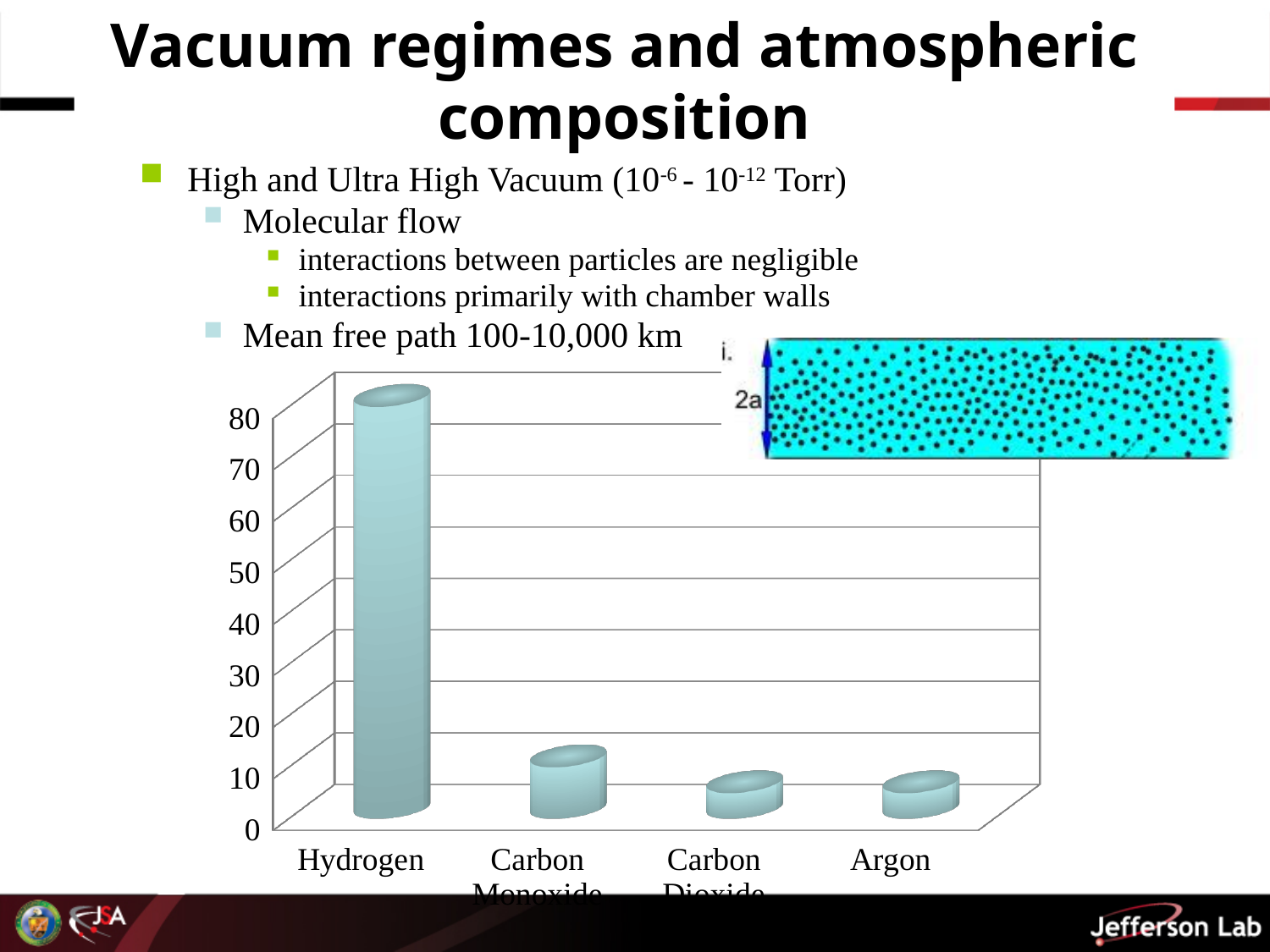
Which is larger, the value for Hydrogen or the value for Carbon Monoxide? Hydrogen Which category is plotted furthest to the left on the chart's horizontal axis? Hydrogen Is the value for Hydrogen greater or less than 70? greater Which is larger, the value for Carbon Monoxide or the value for Argon? Carbon Monoxide How many categories are plotted in the bar chart? 4 Do the bar values generally rise or fall from left to right across the categories? fall Which category has the highest bar in the chart? Hydrogen What kind of chart is shown on the slide? bar chart What is the highest tick value shown on the vertical axis of the chart? 80 Is the value for Carbon Dioxide greater or less than 10? less Is the value for Carbon Monoxide greater or less than 20? less